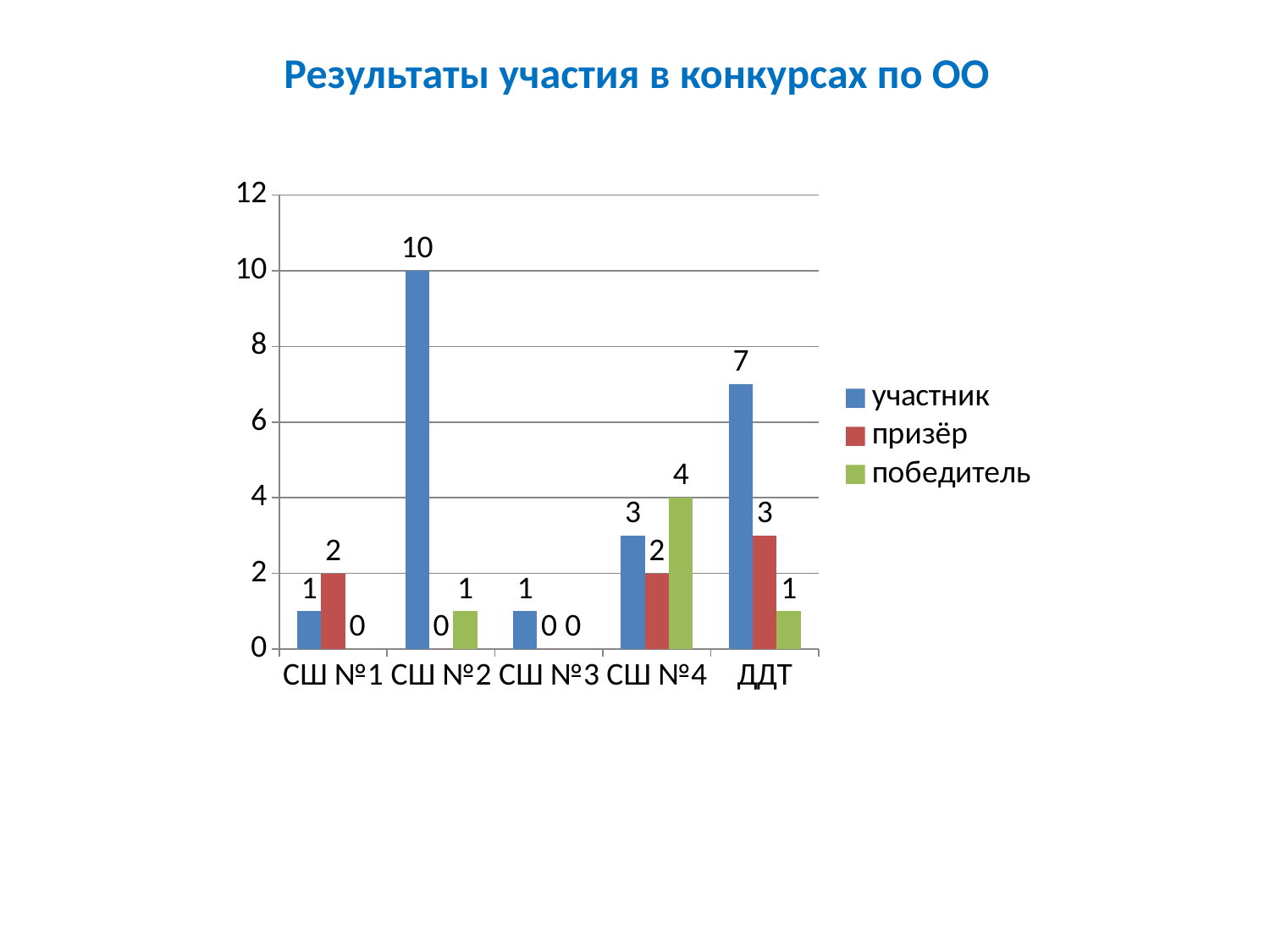
Which series is shown in green in the legend? победитель Which category has the highest value for участник? СШ №2 What is the difference between участник at СШ №2 and участник at ДДТ? 3 What is the value for призёр at ДДТ? 3 Which is larger: призёр at СШ №1 or призёр at ДДТ? призёр at ДДТ Which category has the highest value for победитель? СШ №4 What is the title of the chart? Результаты участия в конкурсах по ОО How many categories are shown on the x axis? 5 What is the value for участник at СШ №2? 10 What kind of chart is shown on the slide? bar chart How many series does the legend list? 3 What is the value for победитель at СШ №4? 4